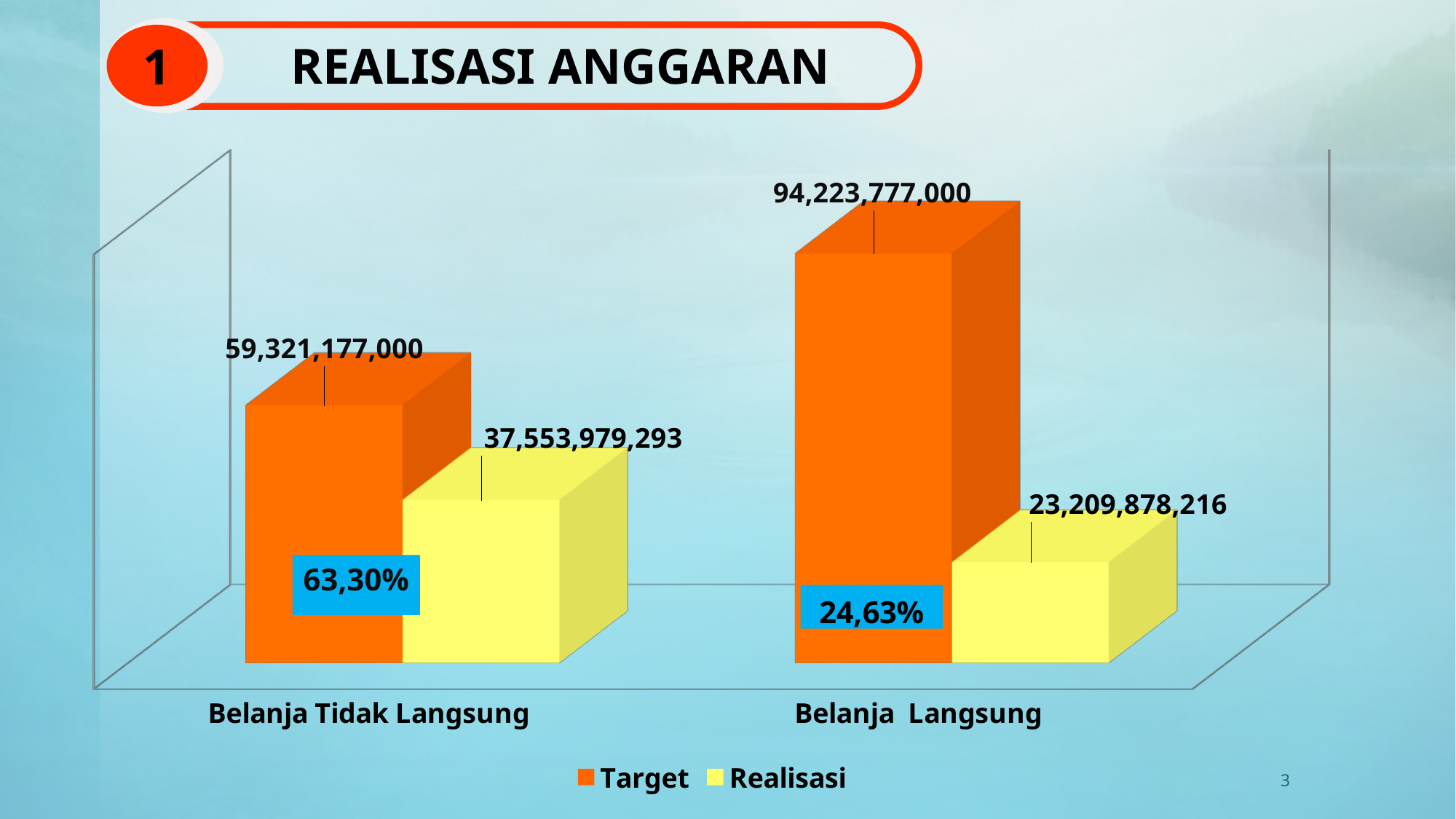
What is the Realisasi value for Belanja Tidak Langsung? 37,553,979,293 What type of chart is shown on the slide? Bar chart What percentage is shown for Belanja Langsung? 24,63% What is the Target value for Belanja Tidak Langsung? 59,321,177,000 How many series does the legend list? 2 Which is larger: the Realisasi for Belanja Tidak Langsung or the Realisasi for Belanja Langsung? Belanja Tidak Langsung What is the difference between Target and Realisasi for Belanja Tidak Langsung? 21,767,197,707 What is the Target value for Belanja Langsung? 94,223,777,000 What is the Realisasi value for Belanja Langsung? 23,209,878,216 Which category has the lowest Realisasi value? Belanja Langsung What is the difference between the Target values of Belanja Langsung and Belanja Tidak Langsung? 34,902,600,000 Which category has the highest Target value? Belanja Langsung